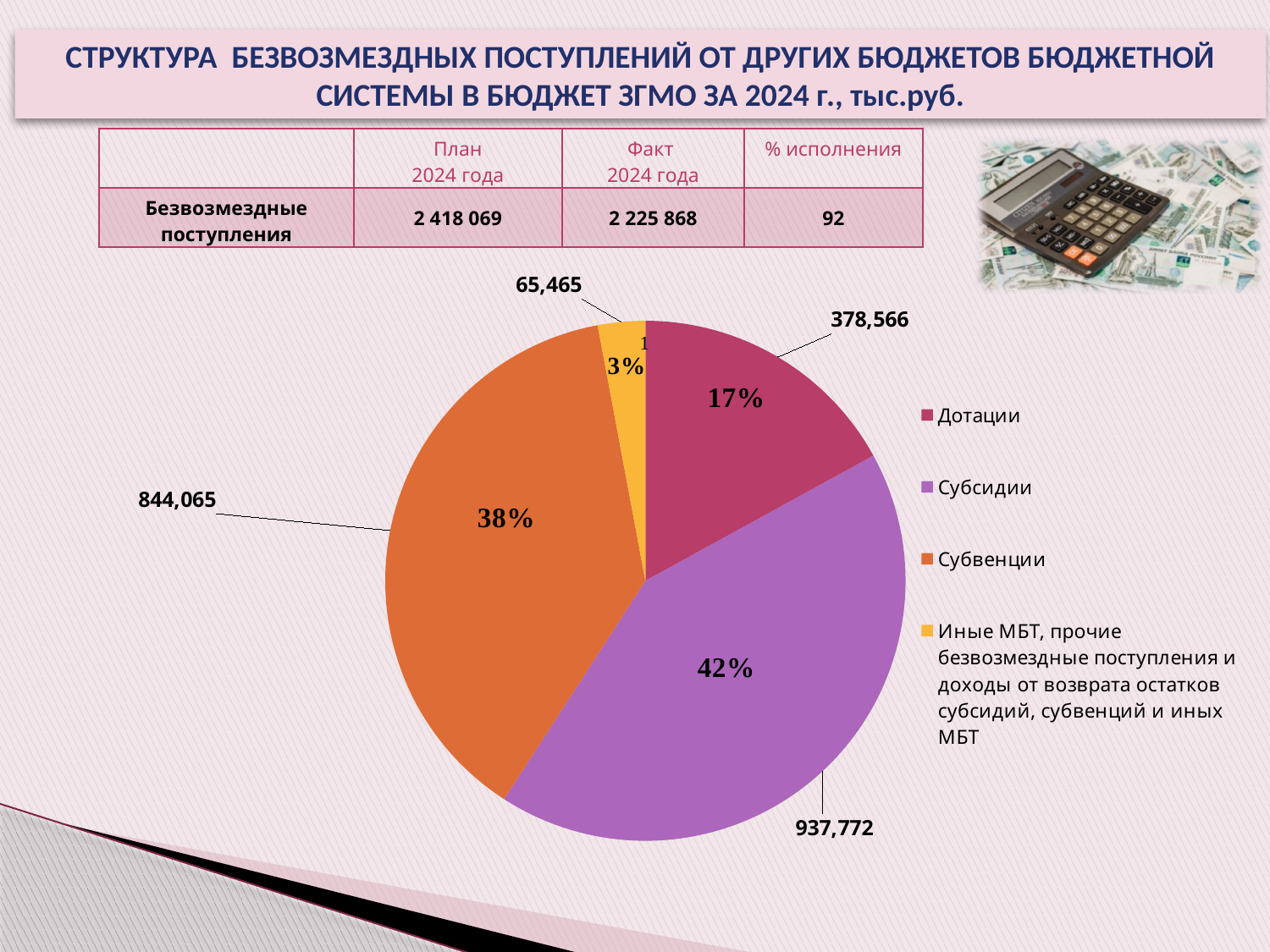
What is the value for the slice 'Иные МБТ, прочие безвозмездные поступления и доходы от возврата остатков субсидий, субвенций и иных МБТ'? 65,465 What is the value for Субсидии in the pie chart? 937,772 Which category has the largest slice in the pie chart? Субсидии What share of the pie does Дотации represent? 17% What type of chart is shown on the slide? pie chart What is the value for Дотации in the pie chart? 378,566 What share of the pie does Субвенции represent? 38% What is the difference between the values for Субсидии and Субвенции? 93,707 Which category has the smallest slice in the pie chart? Иные МБТ, прочие безвозмездные поступления и доходы от возврата остатков субсидий, субвенций и иных МБТ What is the value for Субвенции in the pie chart? 844,065 How many categories does the legend of the pie chart list? 4 Which is larger, the value for Дотации or the value for Субвенции? Субвенции